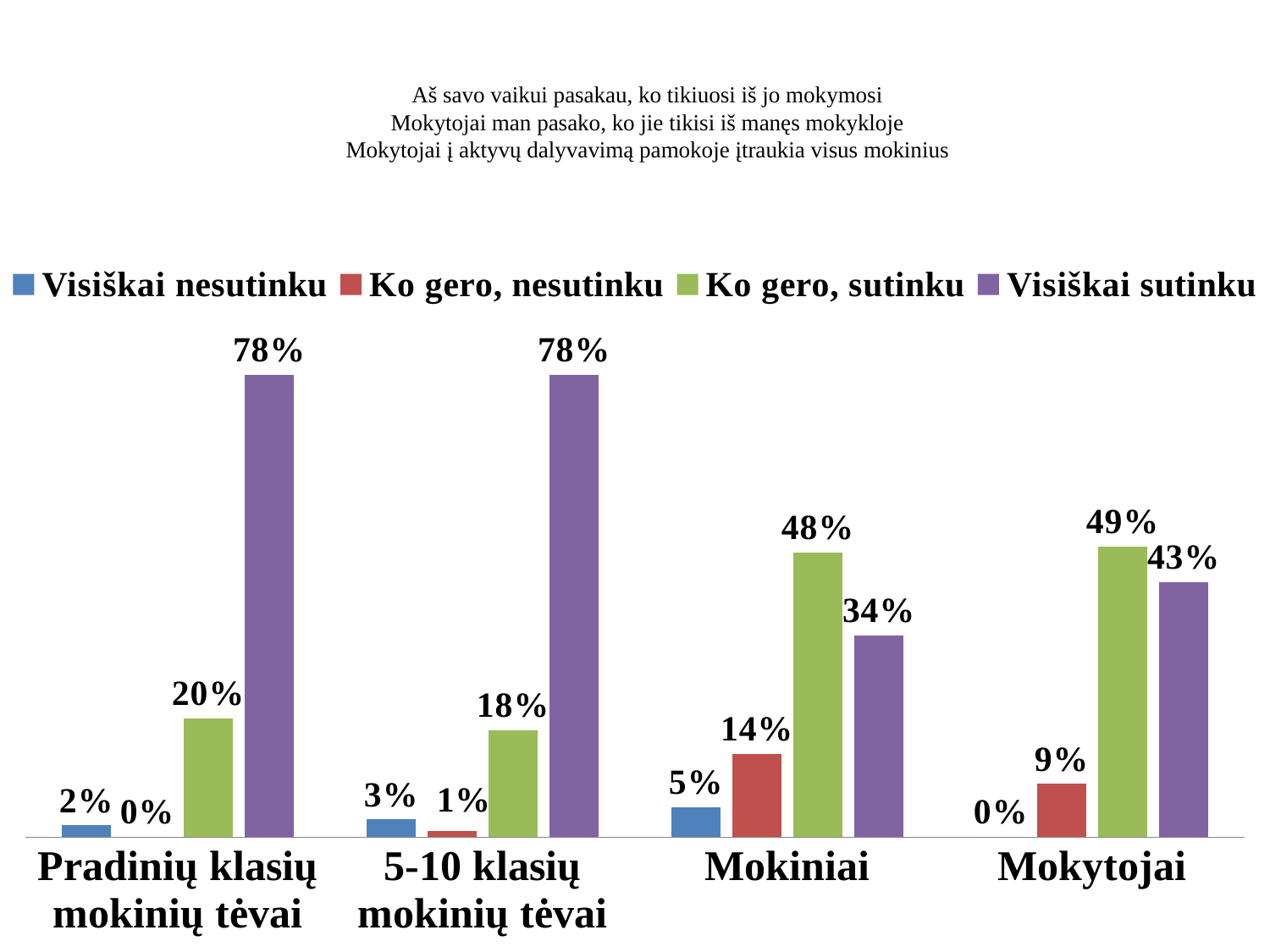
Which legend entry is shown in purple? Visiškai sutinku What is the value for "Ko gero, sutinku" in the "Mokytojai" category? 49% Which category has the highest value for "Ko gero, sutinku"? Mokytojai What is the value for "Visiškai sutinku" in the "Pradinių klasių mokinių tėvai" category? 78% Which category has the lowest value for "Visiškai sutinku"? Mokiniai What kind of chart is shown on the slide? Bar chart Which is larger in the "Mokytojai" category: "Ko gero, sutinku" or "Visiškai sutinku"? Ko gero, sutinku What is the value for "Ko gero, nesutinku" in the "Mokiniai" category? 14% What is the value for "Visiškai nesutinku" in the "5-10 klasių mokinių tėvai" category? 3% How many categories are shown on the x axis? 4 How many series does the legend list? 4 What is the difference between the "Ko gero, sutinku" and "Visiškai sutinku" values in the "Mokiniai" category? 14%